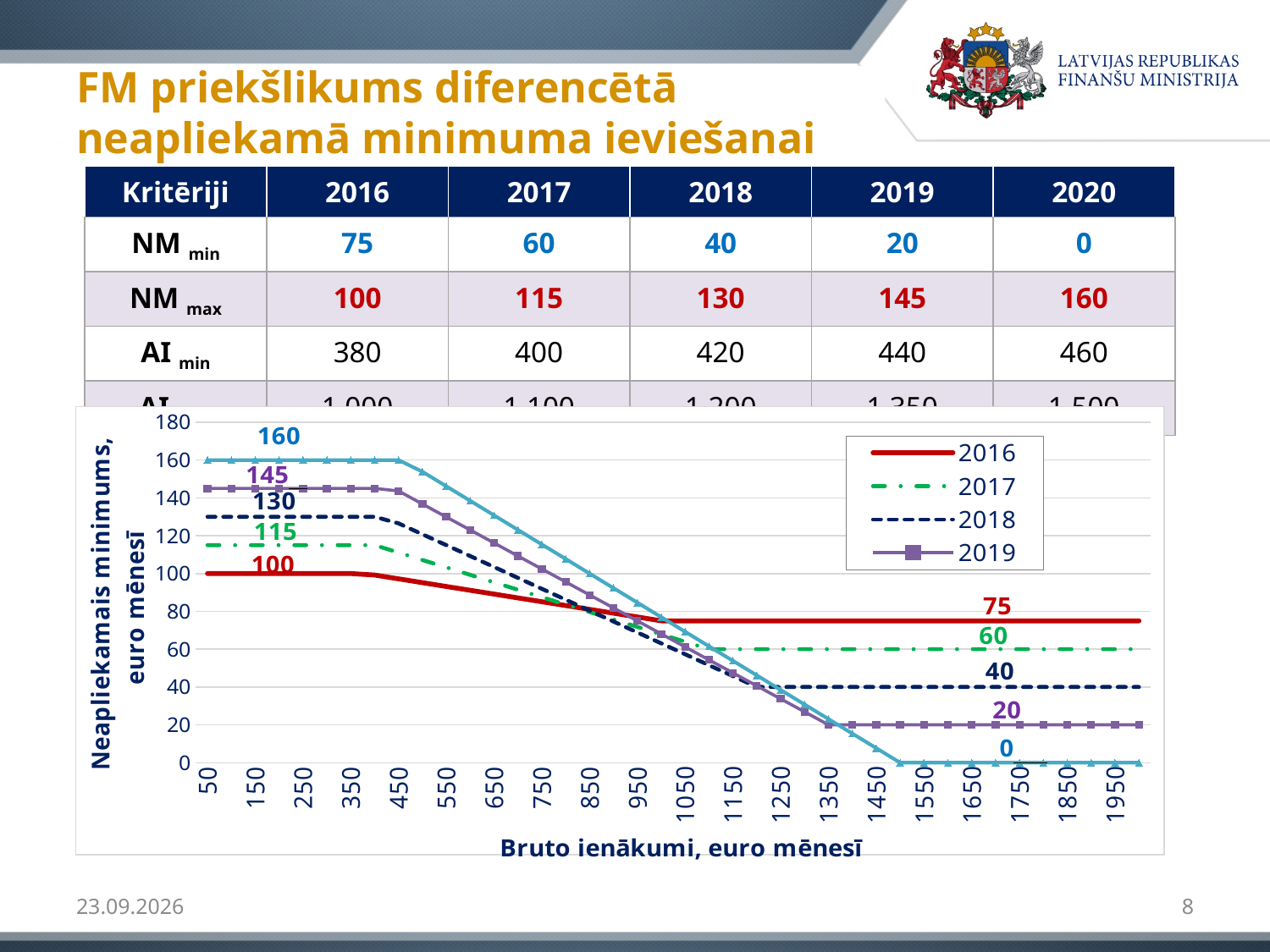
What kind of chart is shown on the slide? line chart At a gross income of 1950, which is larger: the 2016 line or the 2019 line? 2016 What is the highest value labelled on the 2016 line? 100 What is the difference between the starting value (115) and the final value (60) of the 2017 line? 55 What is the title of the x axis of the chart? Bruto ienākumi, euro mēnesī What is the starting value labelled on the 2019 line? 145 What is the difference between the starting value (145) and the final value (20) of the 2019 line? 125 How many series does the chart legend list? 4 What value does the 2016 line settle at for high gross incomes? 75 Among the series listed in the legend, which has the lowest value at a gross income of 1950? 2019 Does the 2019 line rise or fall between gross incomes of 450 and 1350? fall What value does the 2018 line settle at on the right side of the chart? 40